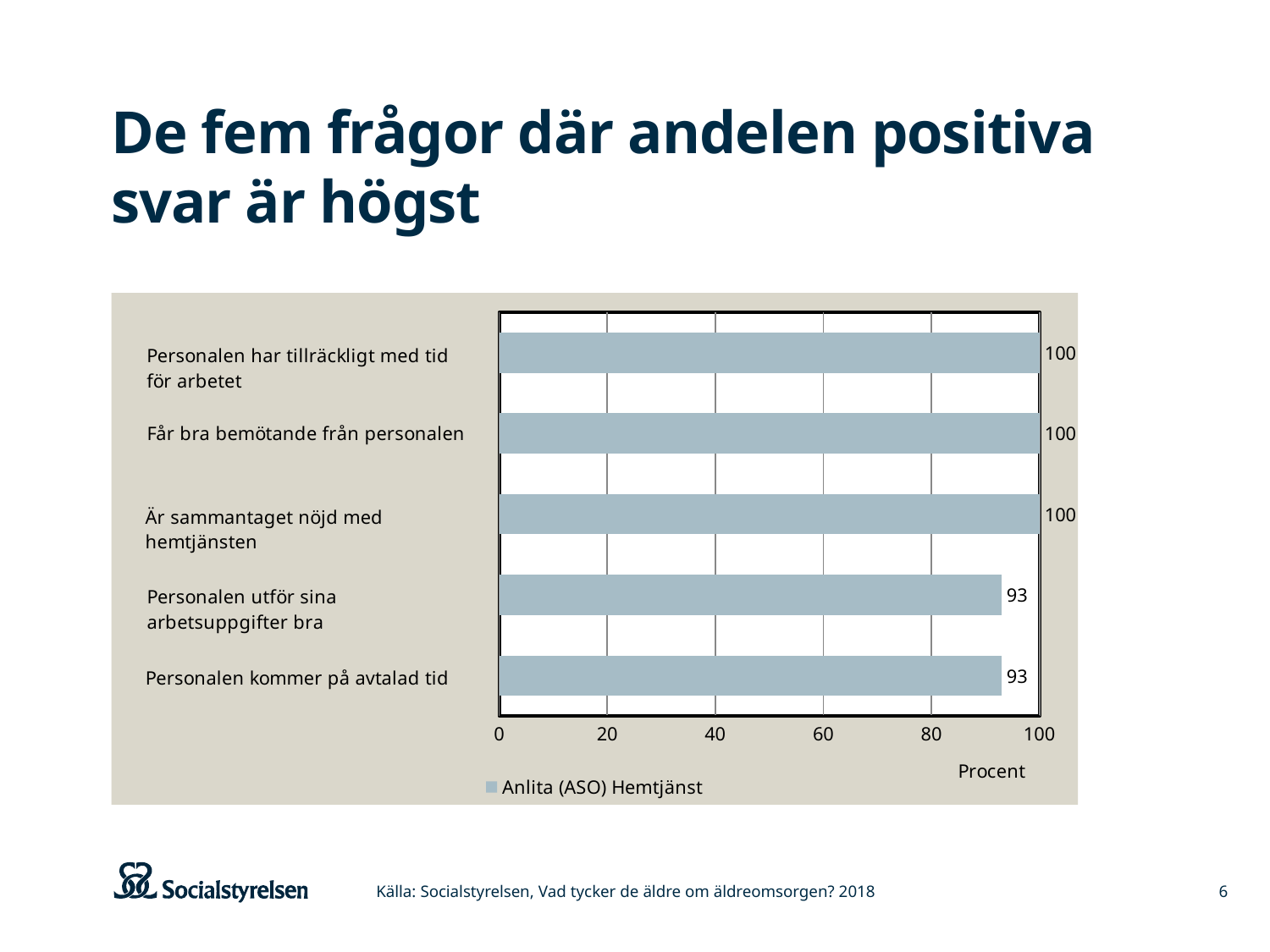
What is the value for "Är sammantaget nöjd med hemtjänsten"? 100 What is the name of the series listed in the legend? Anlita (ASO) Hemtjänst How many series does the legend list? 1 What is the difference between the value for "Personalen har tillräckligt med tid för arbetet" and the value for "Personalen kommer på avtalad tid"? 7 What is the value for "Personalen utför sina arbetsuppgifter bra"? 93 What kind of chart is shown on the slide? bar chart What is the value for "Får bra bemötande från personalen"? 100 What is the value for "Personalen kommer på avtalad tid"? 93 Which is larger, the value for "Får bra bemötande från personalen" or the value for "Personalen utför sina arbetsuppgifter bra"? Får bra bemötande från personalen Is the value for "Personalen kommer på avtalad tid" greater or less than 80? greater How many categories are shown in the chart? 5 What is the label of the horizontal axis? Procent